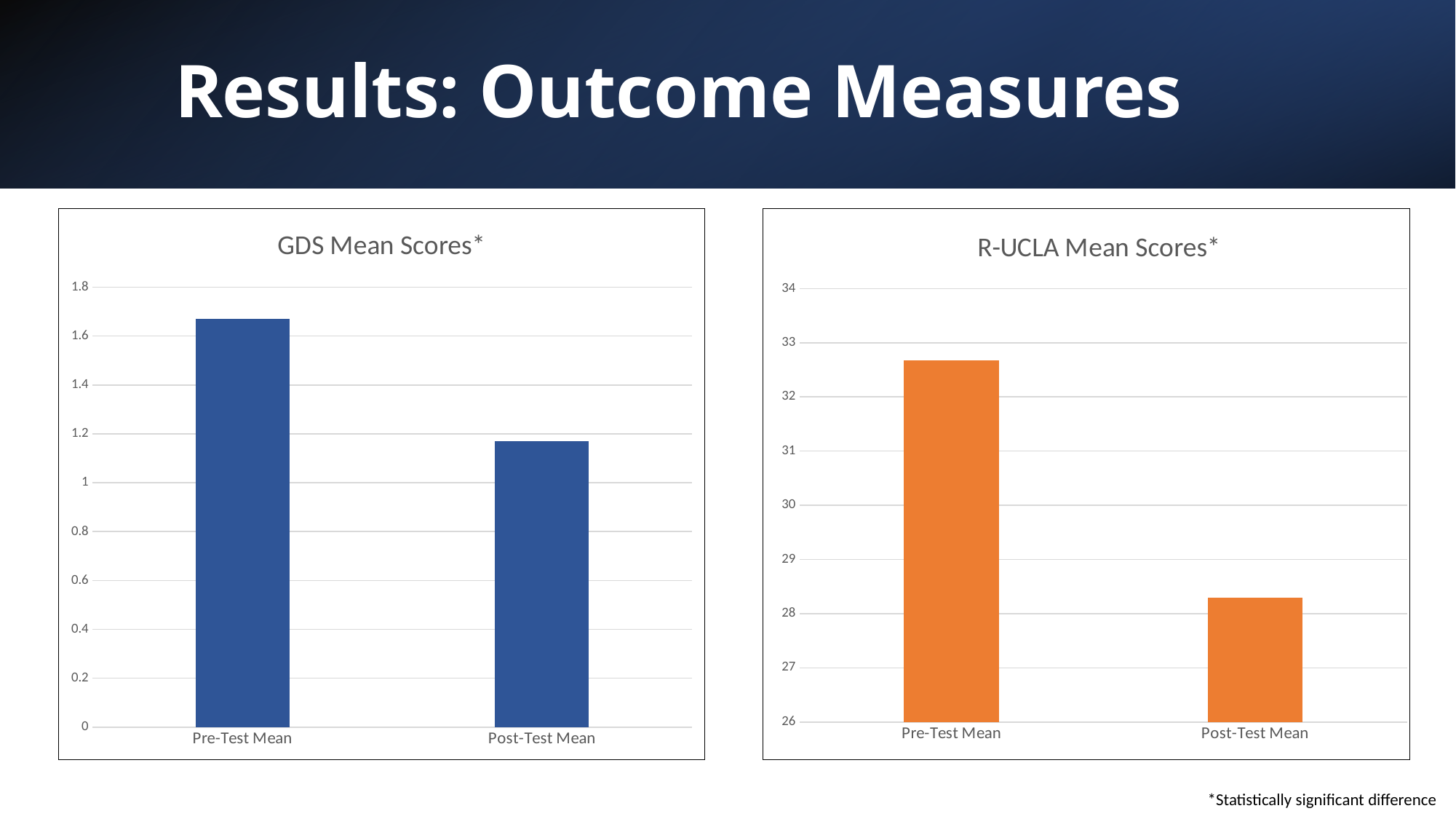
In the GDS Mean Scores chart, is the value for Post-Test Mean greater or less than 1.2? less In the GDS Mean Scores chart, do the values rise or fall from Pre-Test Mean to Post-Test Mean? Fall What type of chart is the R-UCLA Mean Scores chart? Bar chart What colour are the bars in the R-UCLA Mean Scores chart? Orange In the R-UCLA Mean Scores chart, which category has the higher value? Pre-Test Mean In the R-UCLA Mean Scores chart, is the Pre-Test Mean or the Post-Test Mean larger? Pre-Test Mean In the R-UCLA Mean Scores chart, is the value for Post-Test Mean greater or less than 29? less In the GDS Mean Scores chart, is the value for Pre-Test Mean greater or less than 1.6? greater In the GDS Mean Scores chart, which category has the higher value? Pre-Test Mean How many categories are shown in the GDS Mean Scores chart? 2 In the GDS Mean Scores chart, which category has the lower value? Post-Test Mean